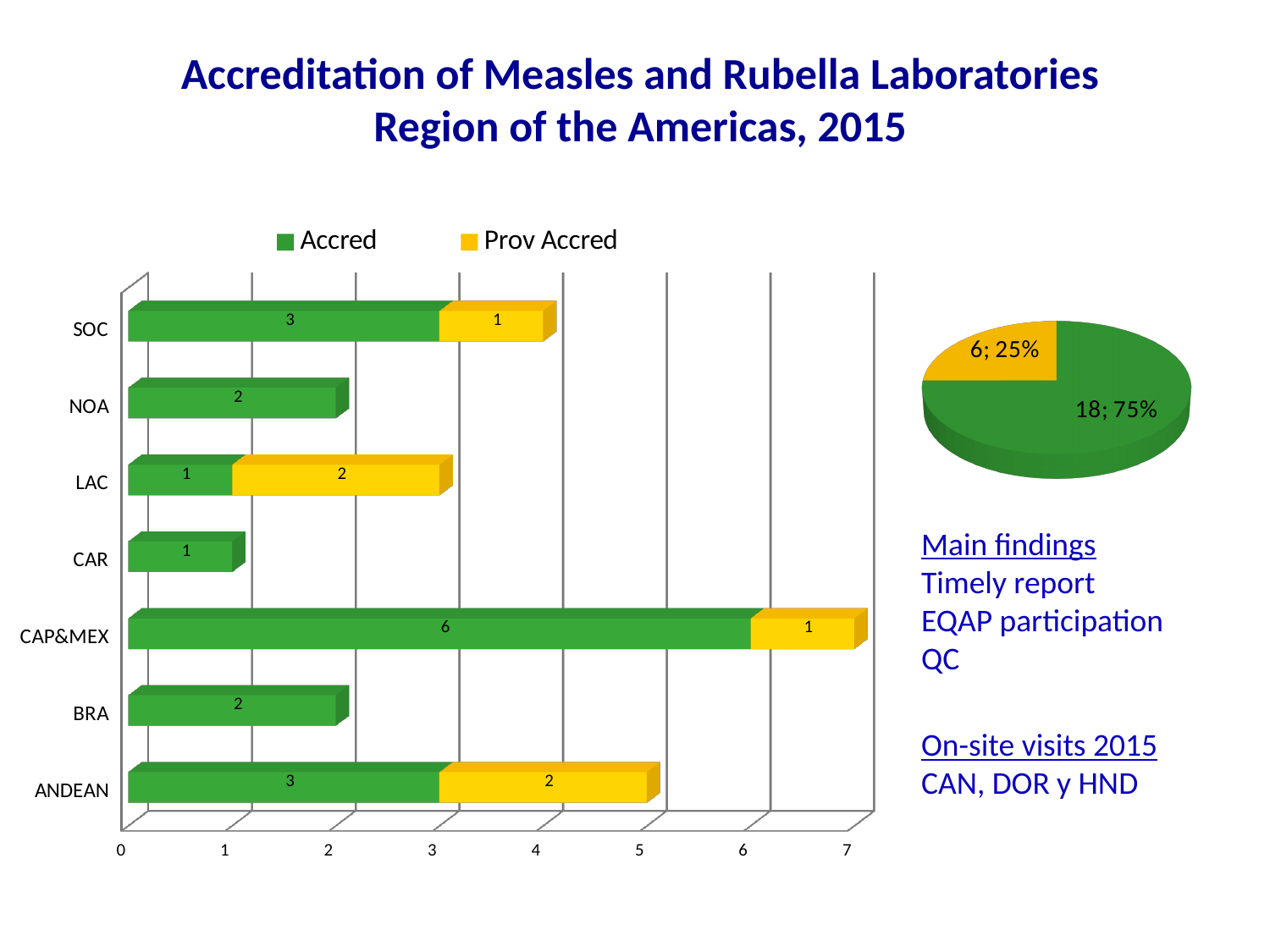
In the pie chart on the right, what is the value shown for the yellow slice? 6 In the pie chart on the right, what share does the green slice represent? 75% How many series does the legend of the bar chart on the left list? 2 How many categories are shown in the bar chart on the left? 7 In the bar chart on the left, which category has the highest Accred value? CAP&MEX What kind of chart is the chart on the left of the slide? bar chart In the bar chart on the left, what is the Accred value for CAP&MEX? 6 In the bar chart on the left, what is the total of the stacked bar for SOC? 4 In the bar chart on the left, what is the difference between the Accred values for CAP&MEX and ANDEAN? 3 In the bar chart on the left, which has the larger Prov Accred value, ANDEAN or SOC? ANDEAN In the bar chart on the left, what is the total of the stacked bar for CAP&MEX? 7 In the bar chart on the left, what is the Prov Accred value for LAC? 2